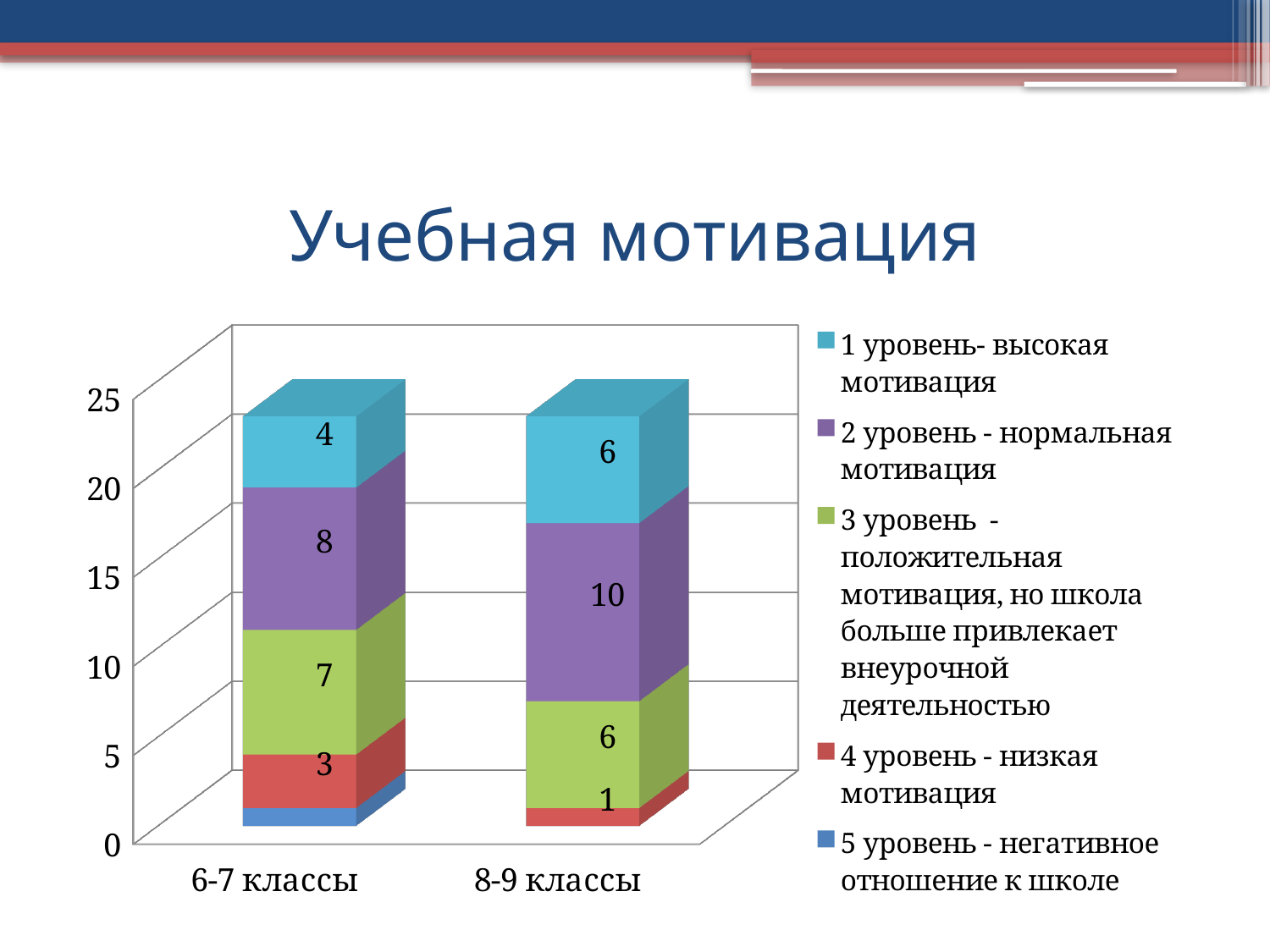
What is the difference between the "2 уровень" values for 8-9 классы and 6-7 классы? 2 What kind of chart is shown on the slide? stacked bar chart What is the title of the slide? Учебная мотивация What is the value for "1 уровень- высокая мотивация" in the 6-7 классы bar? 4 What is the value for "2 уровень - нормальная мотивация" in the 8-9 классы bar? 10 What is the value for "4 уровень - низкая мотивация" in the 8-9 классы bar? 1 Which group has the larger value for "1 уровень- высокая мотивация", 6-7 классы or 8-9 классы? 8-9 классы Which colour represents "5 уровень - негативное отношение к школе" in the legend? blue What is the value for "3 уровень" in the 6-7 классы bar? 7 What is the difference between the "4 уровень - низкая мотивация" values for 6-7 классы and 8-9 классы? 2 How many categories are shown on the x axis? 2 How many series does the legend list? 5